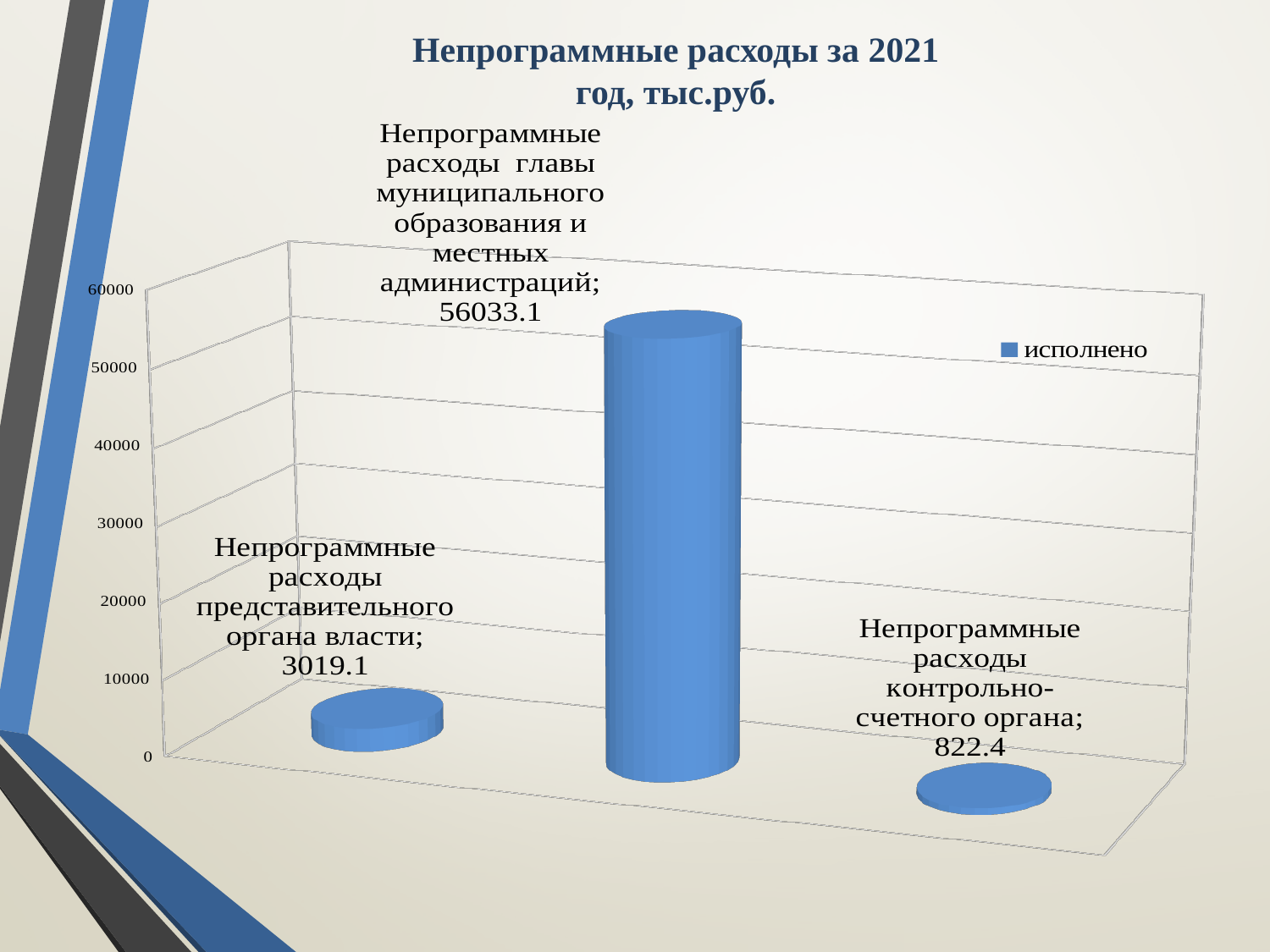
What is the title of the chart? Непрограммные расходы за 2021 год, тыс.руб. Which category has the highest value? Непрограммные расходы главы муниципального образования и местных администраций How many series does the legend list? 1 How many categories are shown in the chart? 3 Which category has the lowest value? Непрограммные расходы контрольно-счетного органа Is the value for 'Непрограммные расходы главы муниципального образования и местных администраций' greater or less than 50000? greater Which is larger: the value for 'Непрограммные расходы представительного органа власти' or the value for 'Непрограммные расходы контрольно-счетного органа'? Непрограммные расходы представительного органа власти What is the value for 'Непрограммные расходы контрольно-счетного органа'? 822.4 What is the difference between the value for 'Непрограммные расходы представительного органа власти' and the value for 'Непрограммные расходы контрольно-счетного органа'? 2196.7 What is the value for 'Непрограммные расходы главы муниципального образования и местных администраций'? 56033.1 What is the value for 'Непрограммные расходы представительного органа власти'? 3019.1 What is the difference between the value for 'Непрограммные расходы главы муниципального образования и местных администраций' and the value for 'Непрограммные расходы представительного органа власти'? 53014.0